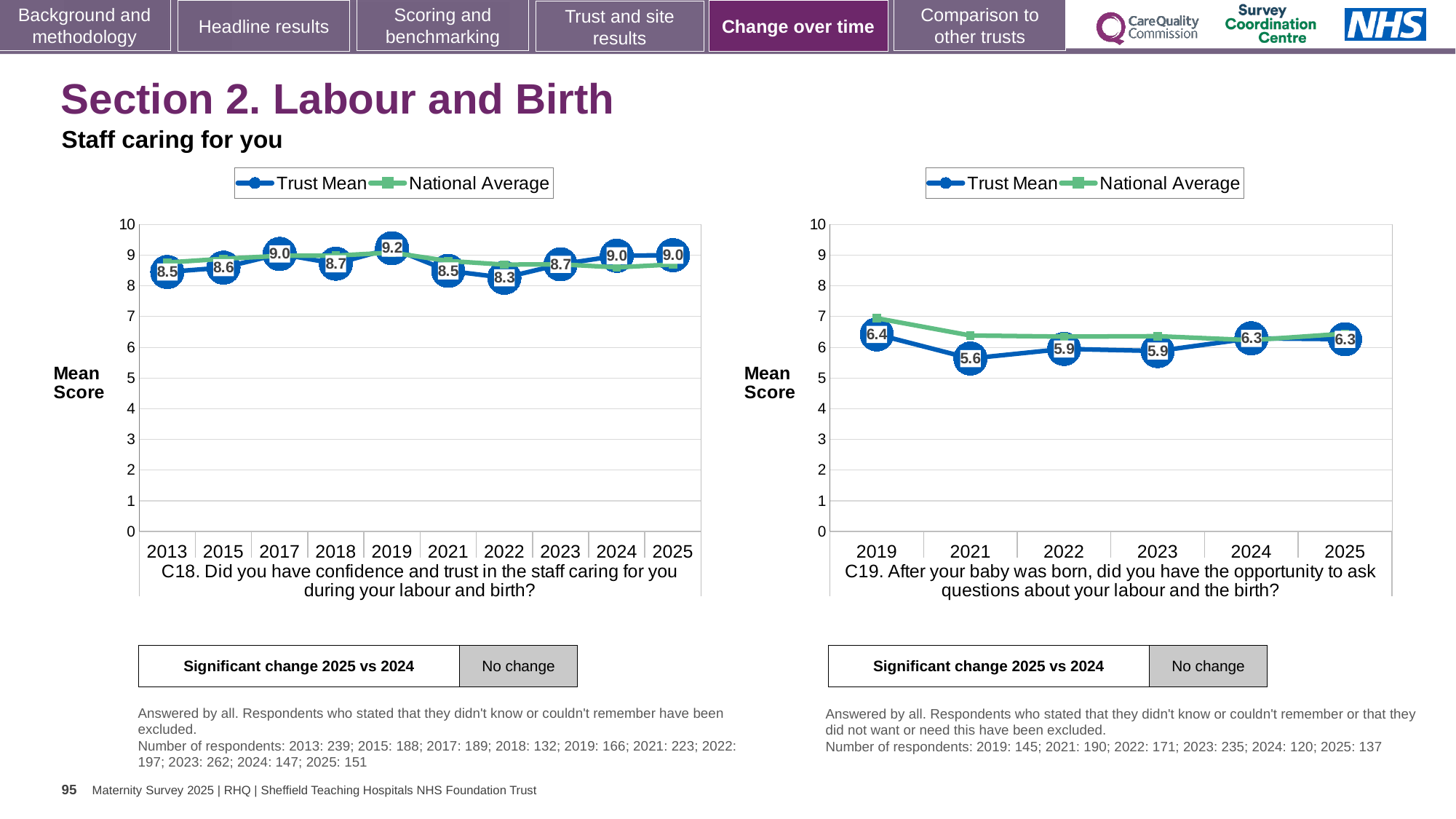
How many series does the legend of the C19 chart (right) list? 2 In the C19 chart (right), what is the Trust Mean for 2021? 5.6 In the C19 chart (right), is the Trust Mean for 2019 larger or smaller than the Trust Mean for 2021? larger In the C18 chart (left), which year has the lowest Trust Mean? 2022 In the C18 chart (left), how many years are plotted on the x axis? 10 In the C19 chart (right), is the National Average for 2019 greater or less than 6? greater In the C18 chart (left), what is the difference between the Trust Mean for 2019 and 2022? 0.9 In the C18 chart (left), what is the Trust Mean for 2019? 9.2 In the C18 chart (left), which year has the highest Trust Mean? 2019 In the C19 chart (right), which year has the lowest Trust Mean? 2021 In the C18 chart (left), what is the Trust Mean for 2022? 8.3 In the C19 chart (right), which year has the highest Trust Mean? 2019